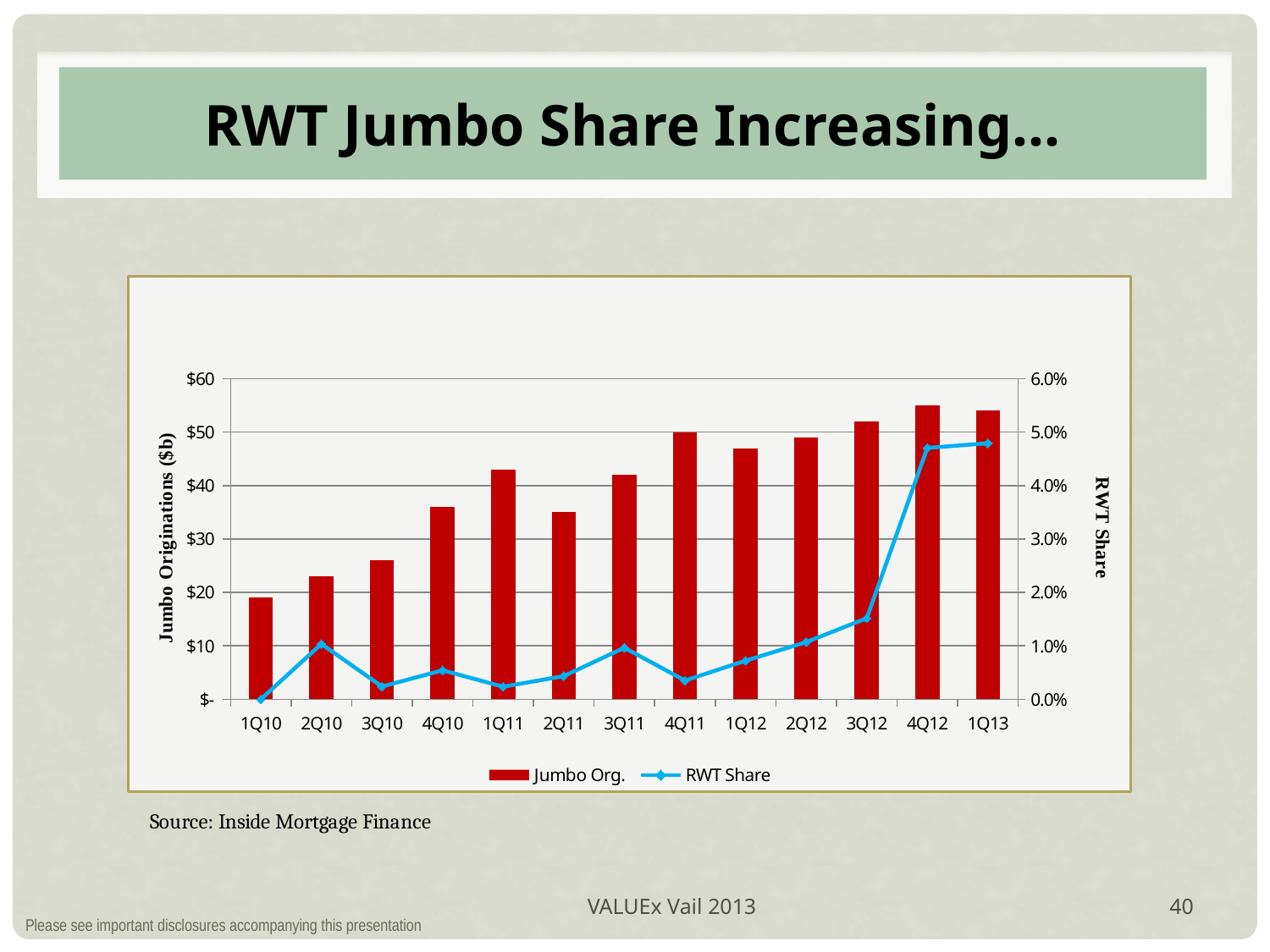
Which quarter has the larger Jumbo Originations bar, 1Q11 or 2Q11? 1Q11 Which quarter has the lowest RWT Share value? 1Q10 Is the Jumbo Originations value for 1Q10 greater or less than $20? less Is the RWT Share value for 4Q12 greater or less than 4.0%? greater How many quarters are shown on the x axis of the chart? 13 What is the title of the slide containing the chart? RWT Jumbo Share Increasing… Which quarter has the lowest Jumbo Originations bar? 1Q10 How many series does the chart legend list? 2 Is the RWT Share value for 3Q12 greater or less than 1.0%? greater What type of chart is shown on the slide? A combination bar and line chart Does the RWT Share line generally rise or fall from 1Q10 to 1Q13? Rise